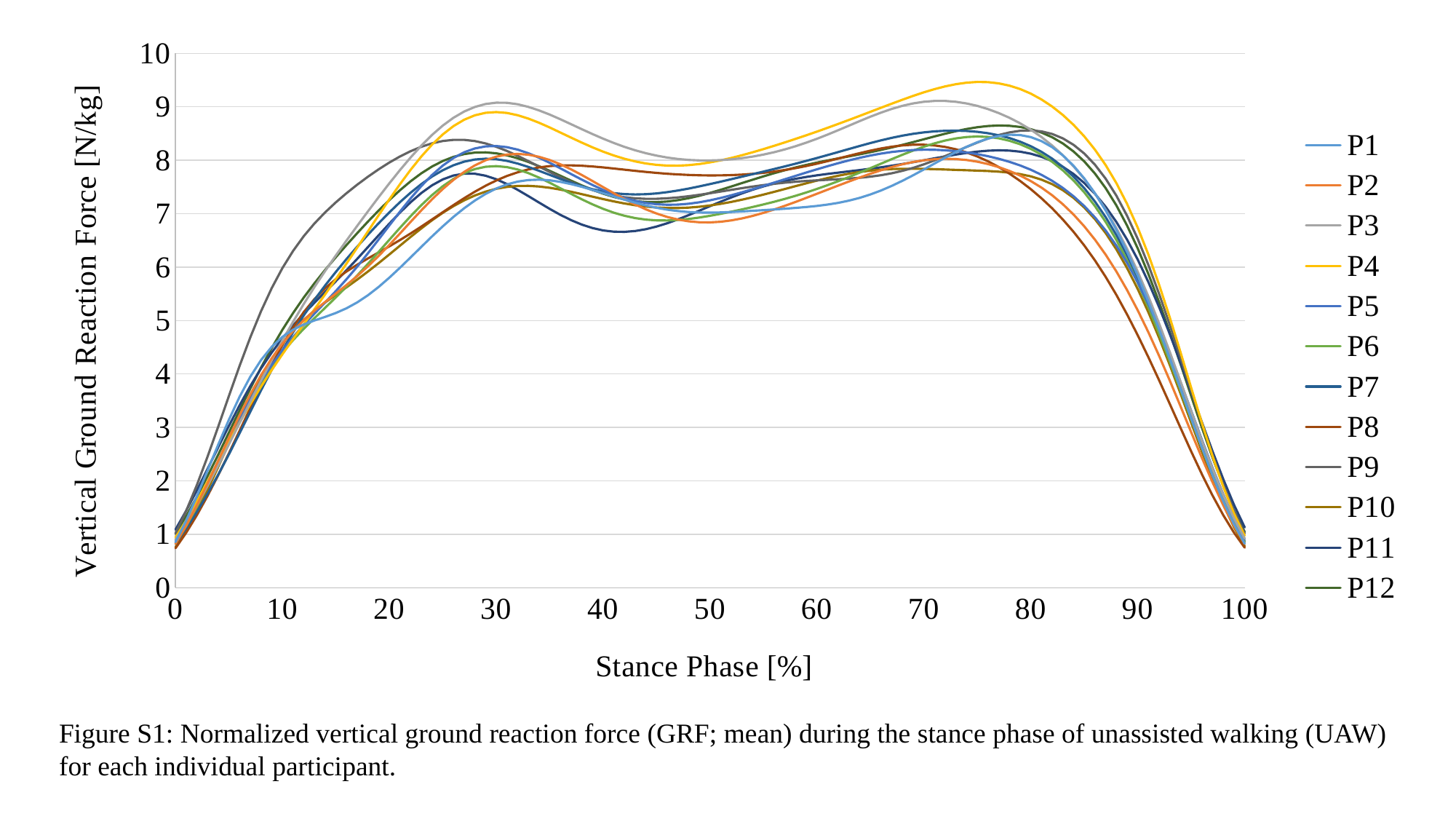
Is the value for P1 at 20% stance phase greater or less than 6? less Do the values rise or fall along the x axis between 80% and 100% stance phase? fall What is the highest value shown on the y axis? 10 What is the label of the x axis? Stance Phase [%] Is the value for P4 at 75% stance phase greater or less than 9? greater What kind of chart is shown on the slide? line chart Which series reaches the highest value anywhere on the chart? P4 What is the label of the y axis? Vertical Ground Reaction Force [N/kg] Do the values rise or fall along the x axis between 0% and 20% stance phase? rise Is the value for P11 at 40% stance phase greater or less than 7? less How many series does the legend list? 12